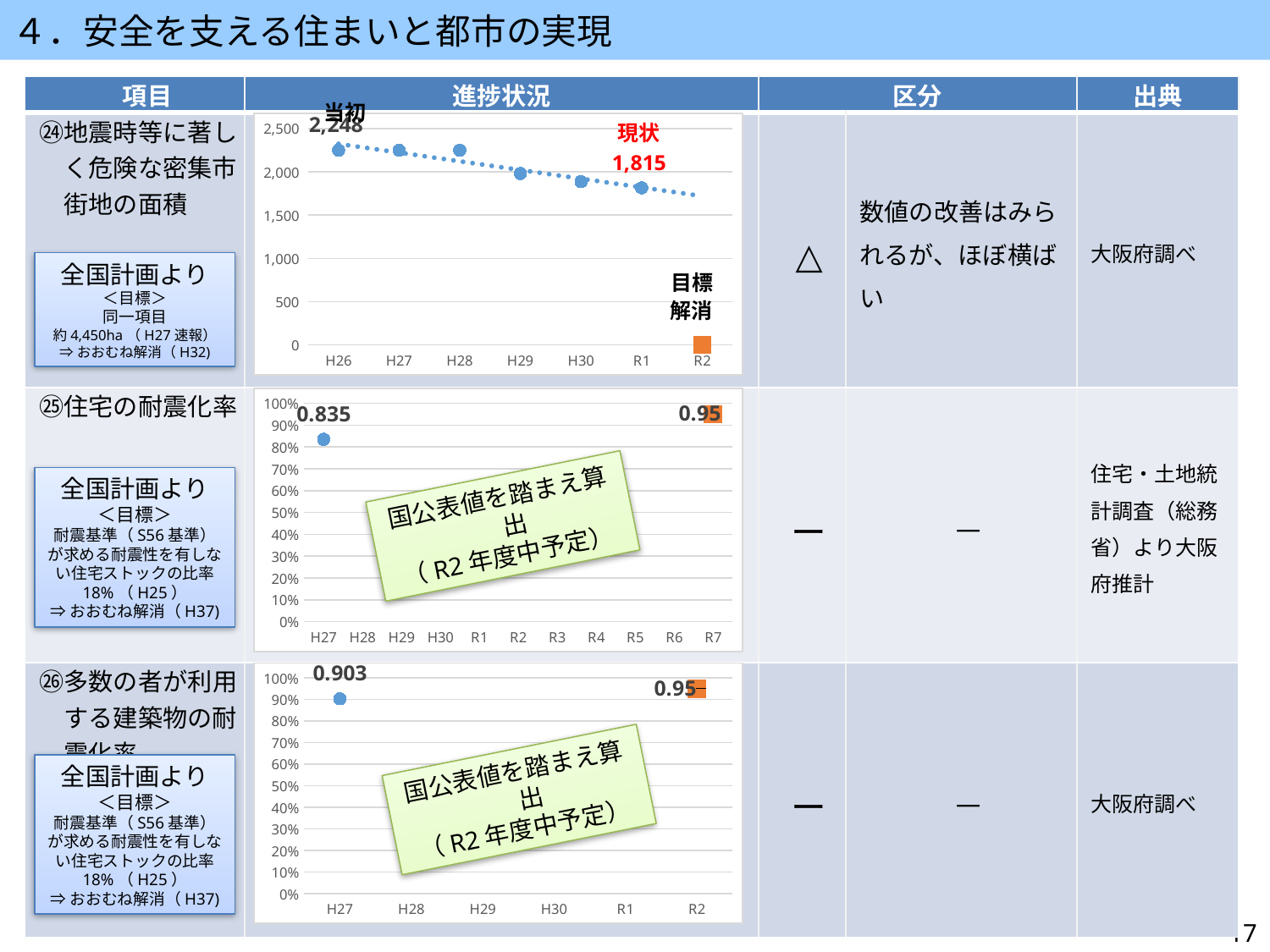
In the bottom chart (㉖ 多数の者が利用する建築物の耐震化率), what is the value plotted for H27? 0.903 In the middle chart (㉕ 住宅の耐震化率), what is the value plotted for H27? 0.835 In the top chart (㉔ 地震時等に著しく危険な密集市街地の面積), is the value for H28 greater or less than 2,000? greater In the top chart (㉔ 地震時等に著しく危険な密集市街地の面積), what is the value labeled 当初 at H26? 2,248 In the top chart (㉔ 地震時等に著しく危険な密集市街地の面積), do the plotted values rise or fall from H26 to R1? fall In the top chart (㉔ 地震時等に著しく危険な密集市街地の面積), what is the value labeled 現状 at R1? 1,815 In the top chart (㉔ 地震時等に著しく危険な密集市街地の面積), is the value for H30 greater or less than 2,000? less In the top chart (㉔ 地震時等に著しく危険な密集市街地の面積), what is the label shown for the R2 target? 目標 解消 In the middle chart (㉕ 住宅の耐震化率), how many categories are shown on the x axis? 11 In the middle chart (㉕ 住宅の耐震化率), what is the target value shown at R7? 0.95 In the top chart (㉔ 地震時等に著しく危険な密集市街地の面積), how many categories are shown on the x axis? 7 In the top chart (㉔ 地震時等に著しく危険な密集市街地の面積), what is the difference between the 当初 value (2,248) and the 現状 value (1,815)? 433